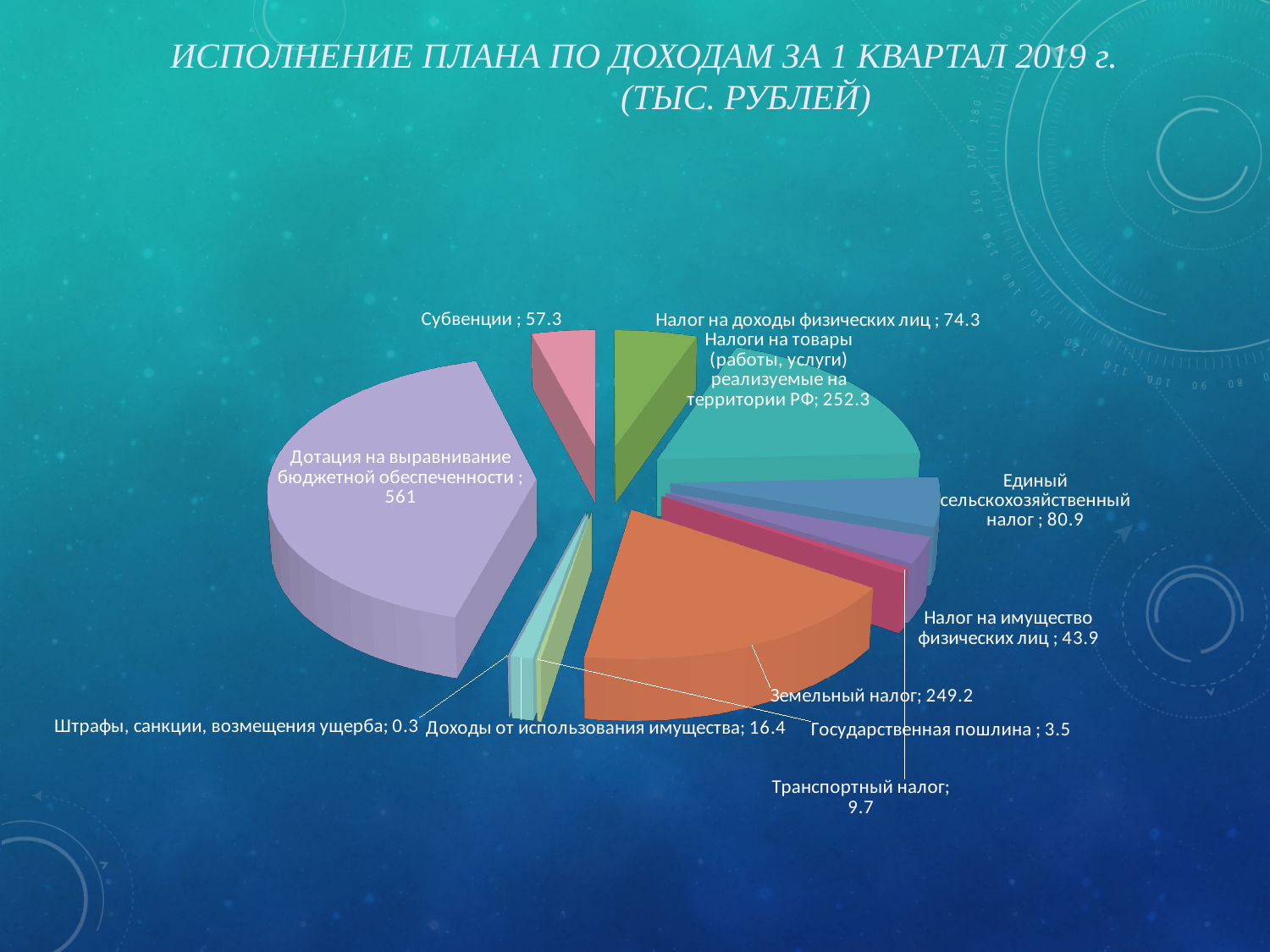
What is the difference between the values for Дотация на выравнивание бюджетной обеспеченности and Налоги на товары (работы, услуги) реализуемые на территории РФ? 308.7 What is the value for Земельный налог? 249.2 What is the difference between the values for Единый сельскохозяйственный налог and Субвенции? 23.6 Which category has the largest value in the pie chart? Дотация на выравнивание бюджетной обеспеченности What is the value for Налоги на товары (работы, услуги) реализуемые на территории РФ? 252.3 What is the value for Транспортный налог? 9.7 What is the title of the chart on the slide? Исполнение плана по доходам за 1 квартал 2019 г. (тыс. рублей) What type of chart is shown on the slide? Pie chart Which is larger: Единый сельскохозяйственный налог or Налог на доходы физических лиц? Единый сельскохозяйственный налог How many categories (slices) does the pie chart have? 11 Which category has the smallest value in the pie chart? Штрафы, санкции, возмещения ущерба What is the value for Дотация на выравнивание бюджетной обеспеченности? 561